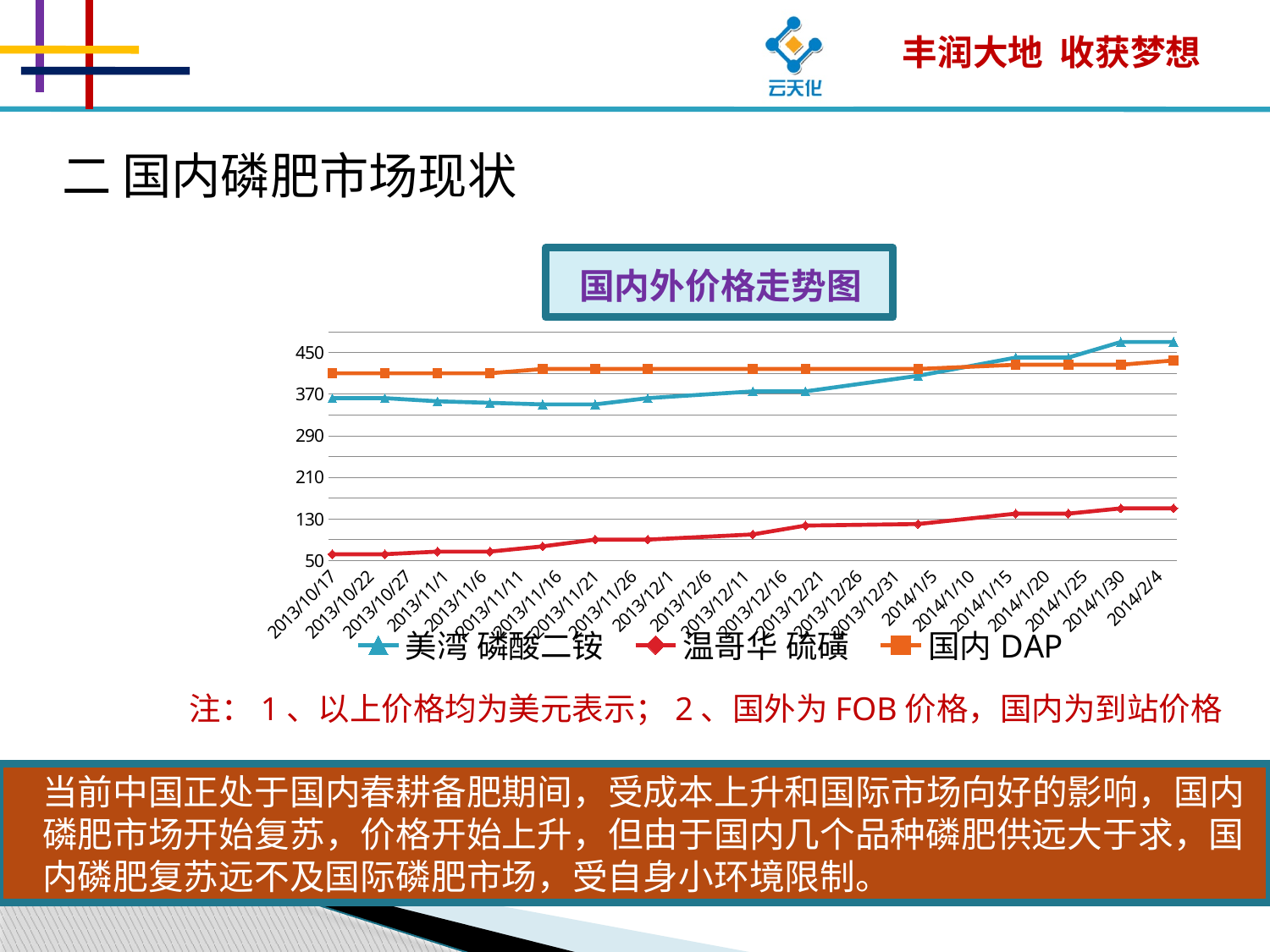
Is the value for 美湾 磷酸二铵 on 2014/2/4 greater or less than 450? greater Is the value for 温哥华 硫磺 on 2013/10/17 greater or less than 130? less How many series does the legend of the chart list? 3 On 2014/2/4, which is higher: 美湾 磷酸二铵 or 国内 DAP? 美湾 磷酸二铵 Is the value for 国内 DAP on 2013/10/17 greater or less than 370? greater On 2013/10/17, which is higher: 美湾 磷酸二铵 or 国内 DAP? 国内 DAP Which series has the lowest values across the whole period shown? 温哥华 硫磺 What kind of chart is shown under the title 国内外价格走势图? line chart How many dates are labelled along the x axis of the chart? 23 Which series is plotted with red diamond markers? 温哥华 硫磺 Does the 温哥华 硫磺 line rise or fall from 2013/10/17 to 2014/2/4? rise